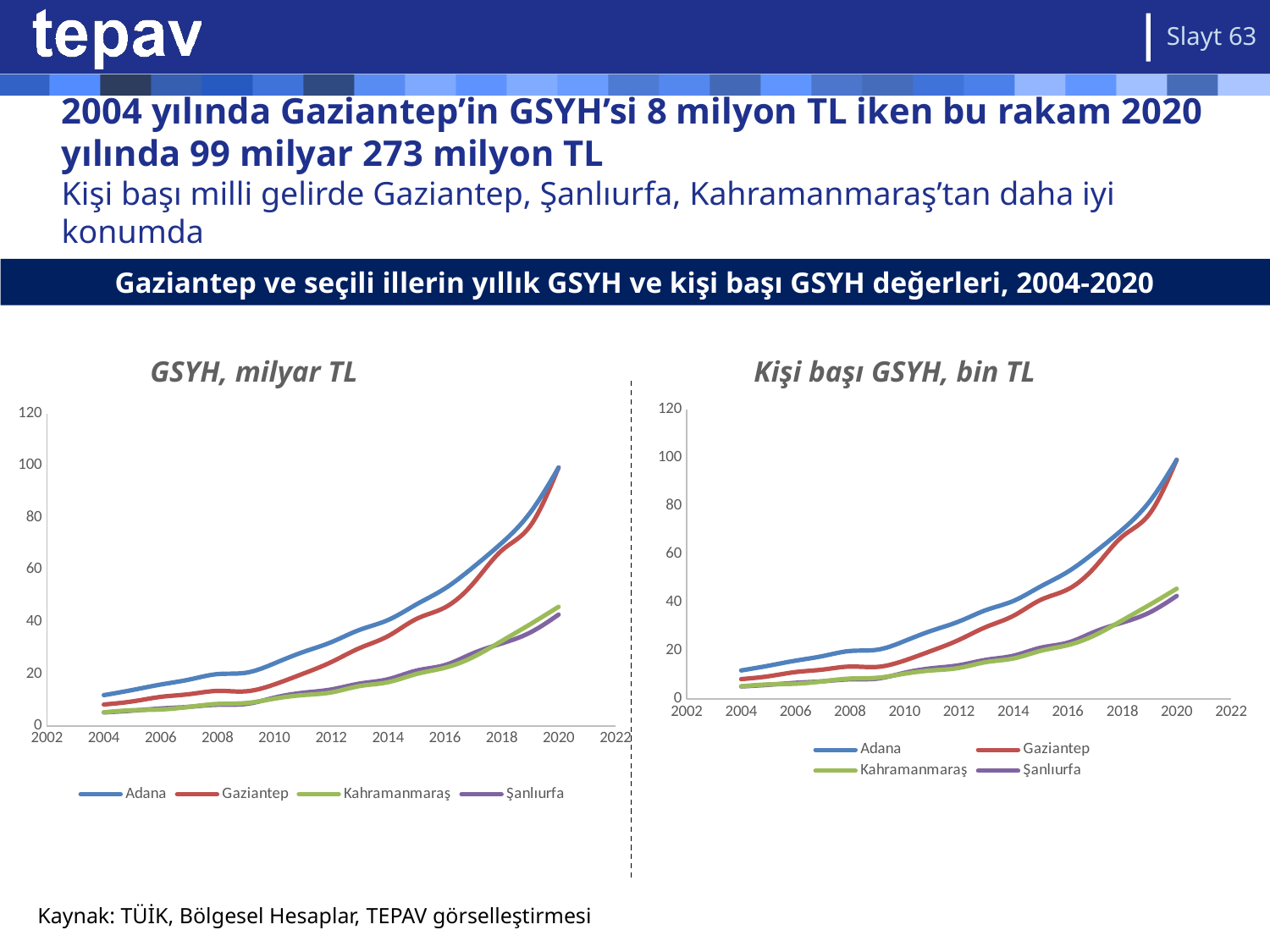
In the right chart 'Kişi başı GSYH, bin TL', does the Şanlıurfa line rise or fall from 2004 to 2020? rise In the right chart 'Kişi başı GSYH, bin TL', is the value for Adana in 2020 greater or less than 80? greater How many series does the legend of the right chart 'Kişi başı GSYH, bin TL' list? 4 In the right chart 'Kişi başı GSYH, bin TL', is the value for Kahramanmaraş in 2004 greater or less than 20? less In the left chart 'GSYH, milyar TL', is the value for Gaziantep in 2004 greater or less than 20? less Which provinces are listed in the legend of the left chart 'GSYH, milyar TL'? Adana, Gaziantep, Kahramanmaraş, Şanlıurfa What kind of chart is the left chart titled 'GSYH, milyar TL'? line chart In the right chart 'Kişi başı GSYH, bin TL', which is larger in 2018: Gaziantep or Şanlıurfa? Gaziantep In the left chart 'GSYH, milyar TL', which is larger in 2020: Adana or Kahramanmaraş? Adana In the left chart 'GSYH, milyar TL', does the Adana line rise or fall from 2004 to 2020? rise